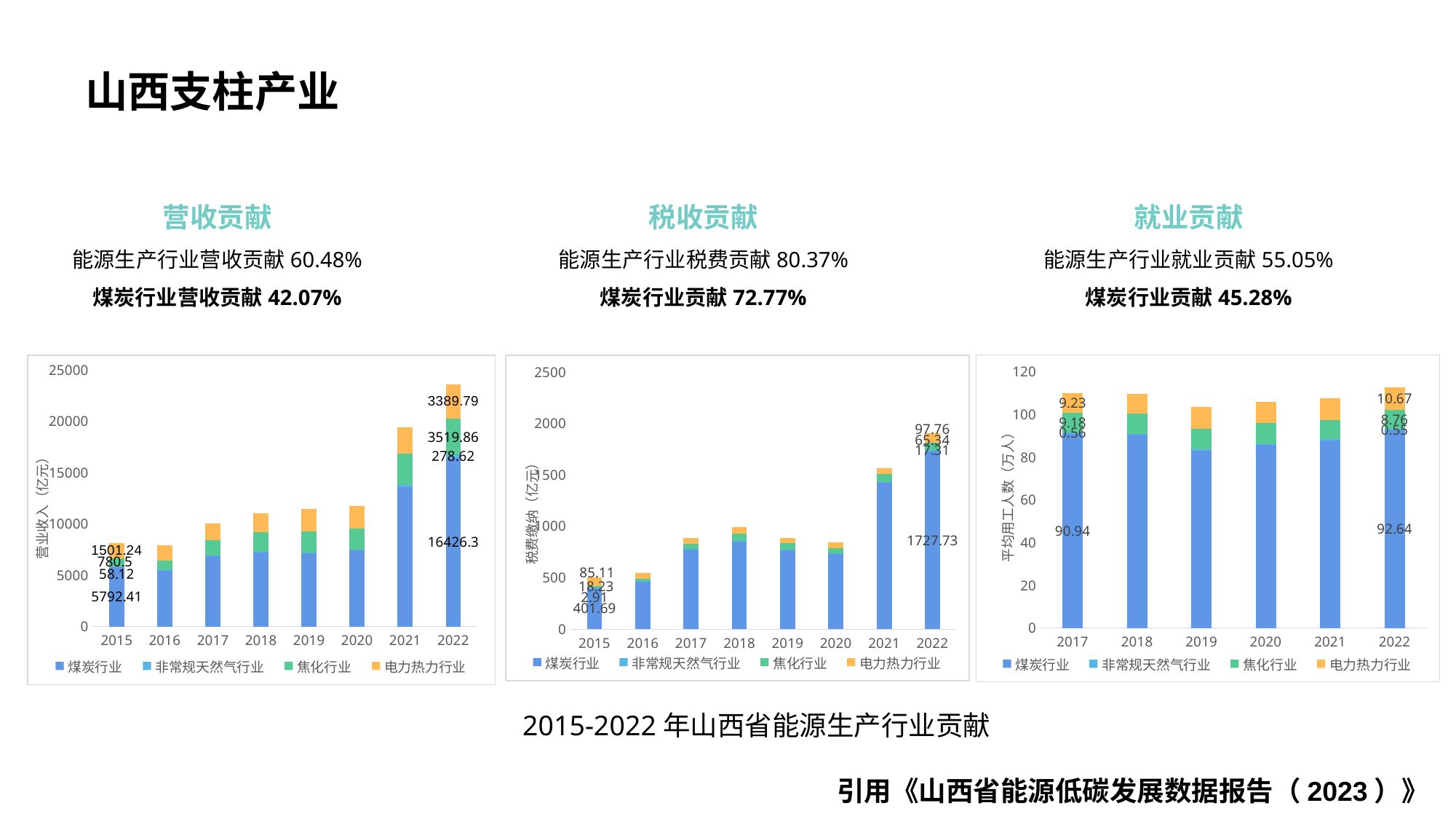
In the middle chart (税费缴纳), what is the value for 电力热力行业 in 2015? 85.11 What kind of chart is the left chart (营业收入)? Stacked bar chart In the middle chart (税费缴纳), what is the total of the stacked bar for 2015? 507.94 In the left chart (营业收入), which is larger in 2022: 焦化行业 or 电力热力行业? 焦化行业 In the right chart (平均用工人数), what is the value for 煤炭行业 in 2017? 90.94 In the left chart (营业收入), which year has the tallest stacked bar? 2022 In the left chart (营业收入), what is the value for 煤炭行业 in 2022? 16426.3 In the left chart (营业收入), what is the difference between the 煤炭行业 values for 2022 and 2015? 10633.89 How many years are shown on the x axis of the right chart (平均用工人数)? 6 In the right chart (平均用工人数), what is the value for 焦化行业 in 2022? 8.76 In the middle chart (税费缴纳), is the total stacked value for 2020 greater or less than 1000? less How many series does the legend of the middle chart (税费缴纳) list? 4